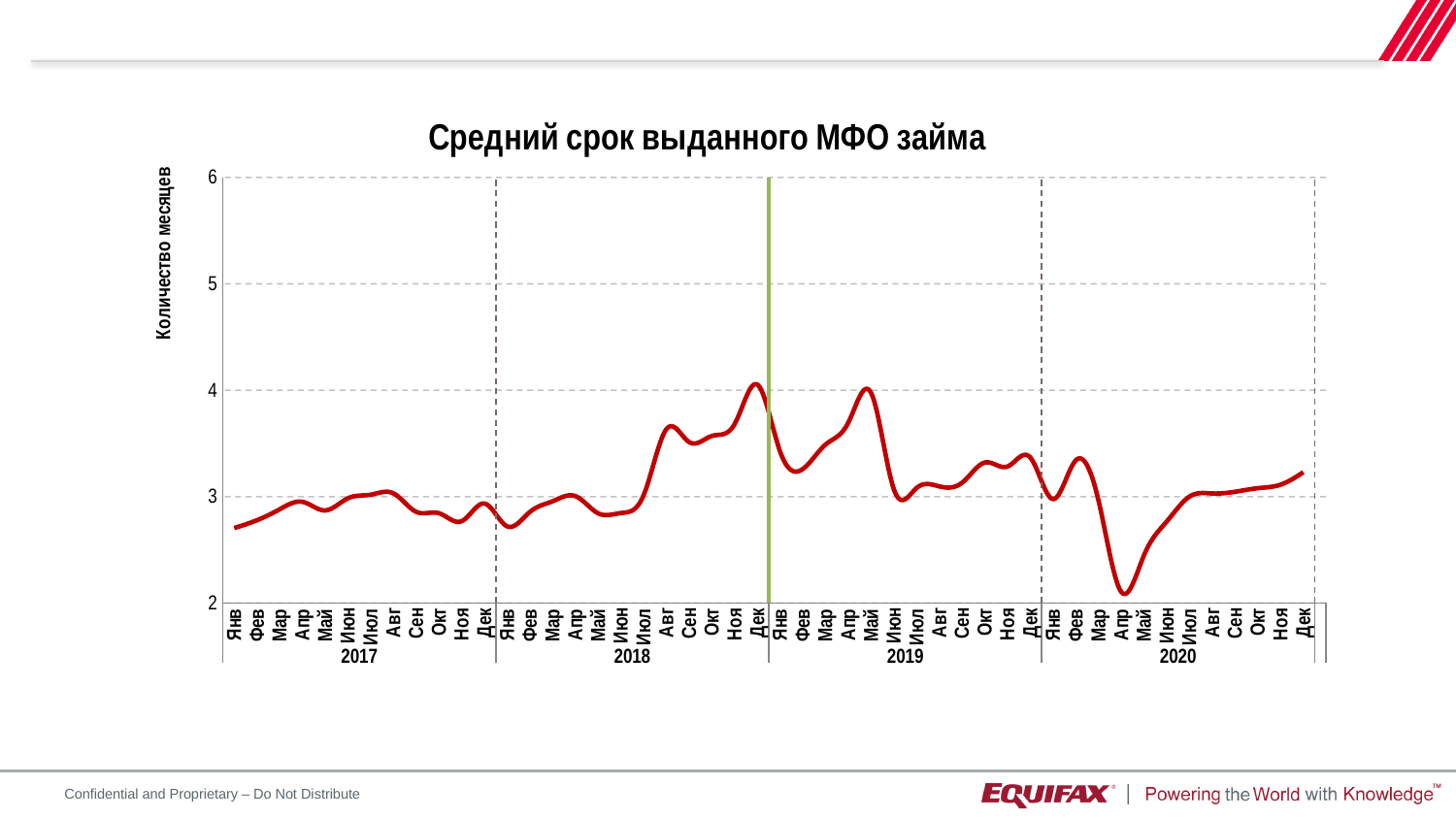
In which month and year does the line reach its lowest point? Апр 2020 How many lines (data series) are plotted on the chart? 1 Which is larger, the value for Дек 2018 or the value for Апр 2020? Дек 2018 Does the line rise or fall from Апр 2020 to Дек 2020? rise Is the value for Апр 2020 greater or less than 3? less Is the value for Дек 2018 greater or less than 3? greater What is the title of the chart? Средний срок выданного МФО займа Is the value for Янв 2017 greater or less than 3? less How many years are covered on the x axis of the chart? 4 What kind of chart is shown on the slide? line chart What is the label of the vertical axis? Количество месяцев